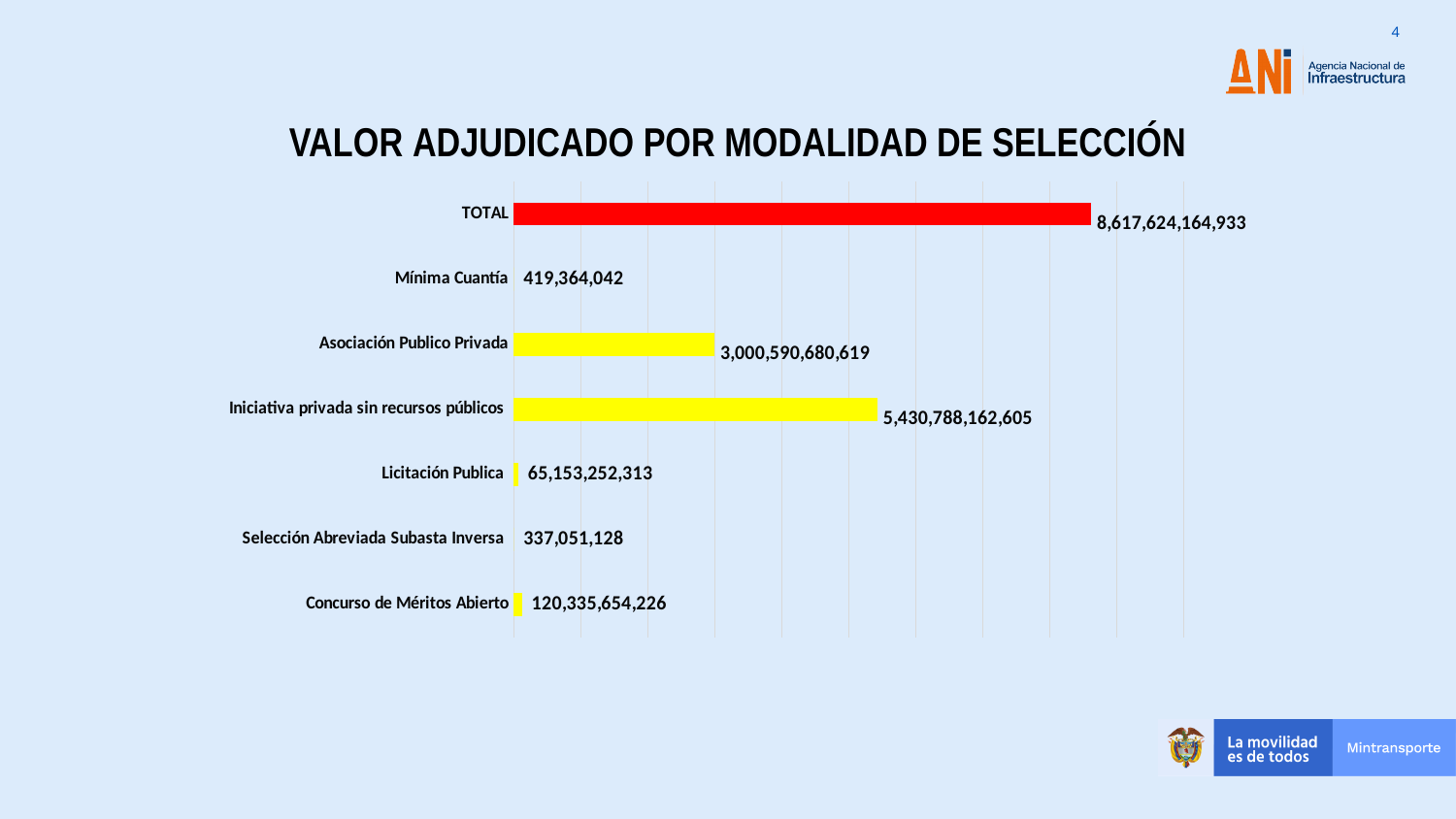
What is the value for Concurso de Méritos Abierto? 120,335,654,226 What kind of chart is shown on the slide? Bar chart What is the value shown for TOTAL? 8,617,624,164,933 Which modality has the lowest value? Selección Abreviada Subasta Inversa How many categories, including TOTAL, are shown in the chart? 7 What is the value for Iniciativa privada sin recursos públicos? 5,430,788,162,605 What is the difference between the values for Concurso de Méritos Abierto and Licitación Publica? 55,182,401,913 What is the difference between the values for Iniciativa privada sin recursos públicos and Asociación Publico Privada? 2,430,197,481,986 What is the value for Asociación Publico Privada? 3,000,590,680,619 What is the value for Mínima Cuantía? 419,364,042 Excluding TOTAL, which modality has the highest value? Iniciativa privada sin recursos públicos Which is larger, the value for Licitación Publica or the value for Concurso de Méritos Abierto? Concurso de Méritos Abierto